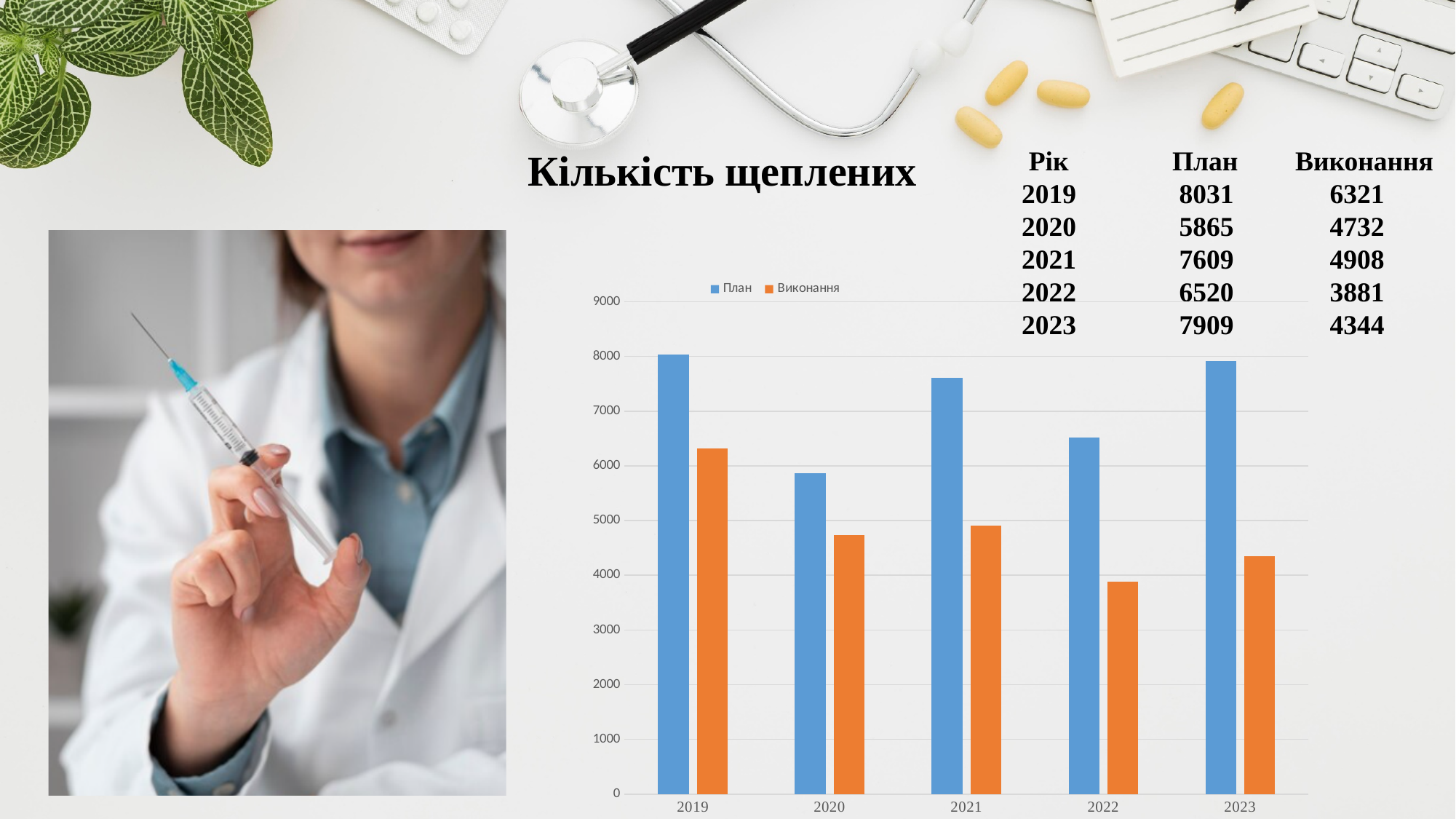
What is the value of Виконання for 2022? 3881 Which is larger, Виконання in 2019 or Виконання in 2020? Виконання in 2019 Is the value of План for 2020 greater or less than 6000? less How many years are shown on the x axis of the chart? 5 What is the value of Виконання for 2023? 4344 What kind of chart is shown on the slide? bar chart What is the title of the chart? Кількість щеплених What is the difference between План and Виконання in 2021? 2701 Which year has the lowest Виконання value? 2022 What is the value of План for 2019? 8031 Which year has the highest План value? 2019 How many series does the chart legend list? 2